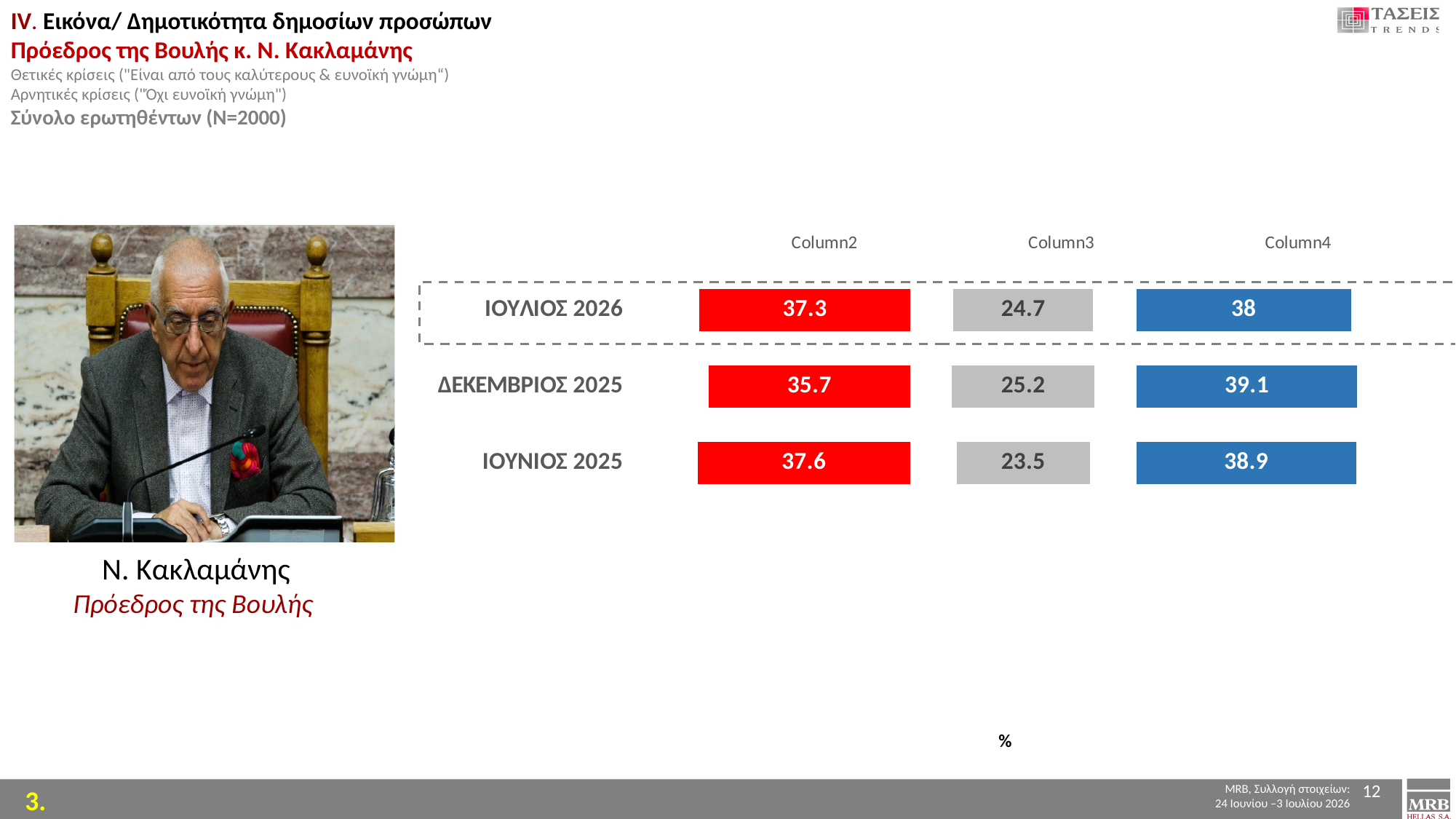
How many time periods are shown in the chart? 3 Which period has the highest Column2 value? ΙΟΥΝΙΟΣ 2025 Which period has the lowest Column3 value? ΙΟΥΝΙΟΣ 2025 What is the Column4 value for ΔΕΚΕΜΒΡΙΟΣ 2025? 39.1 What is the difference between the Column2 values for ΙΟΥΛΙΟΣ 2026 and ΔΕΚΕΜΒΡΙΟΣ 2025? 1.6 What kind of chart is shown on the slide? bar chart What is the total of the stacked bar for ΙΟΥΛΙΟΣ 2026? 100 What is the Column3 value for ΙΟΥΝΙΟΣ 2025? 23.5 How many series does the chart show? 3 What is the difference between the Column4 values for ΔΕΚΕΜΒΡΙΟΣ 2025 and ΙΟΥΛΙΟΣ 2026? 1.1 What is the Column2 value for ΙΟΥΛΙΟΣ 2026? 37.3 For ΙΟΥΛΙΟΣ 2026, which is larger: Column2 or Column4? Column4